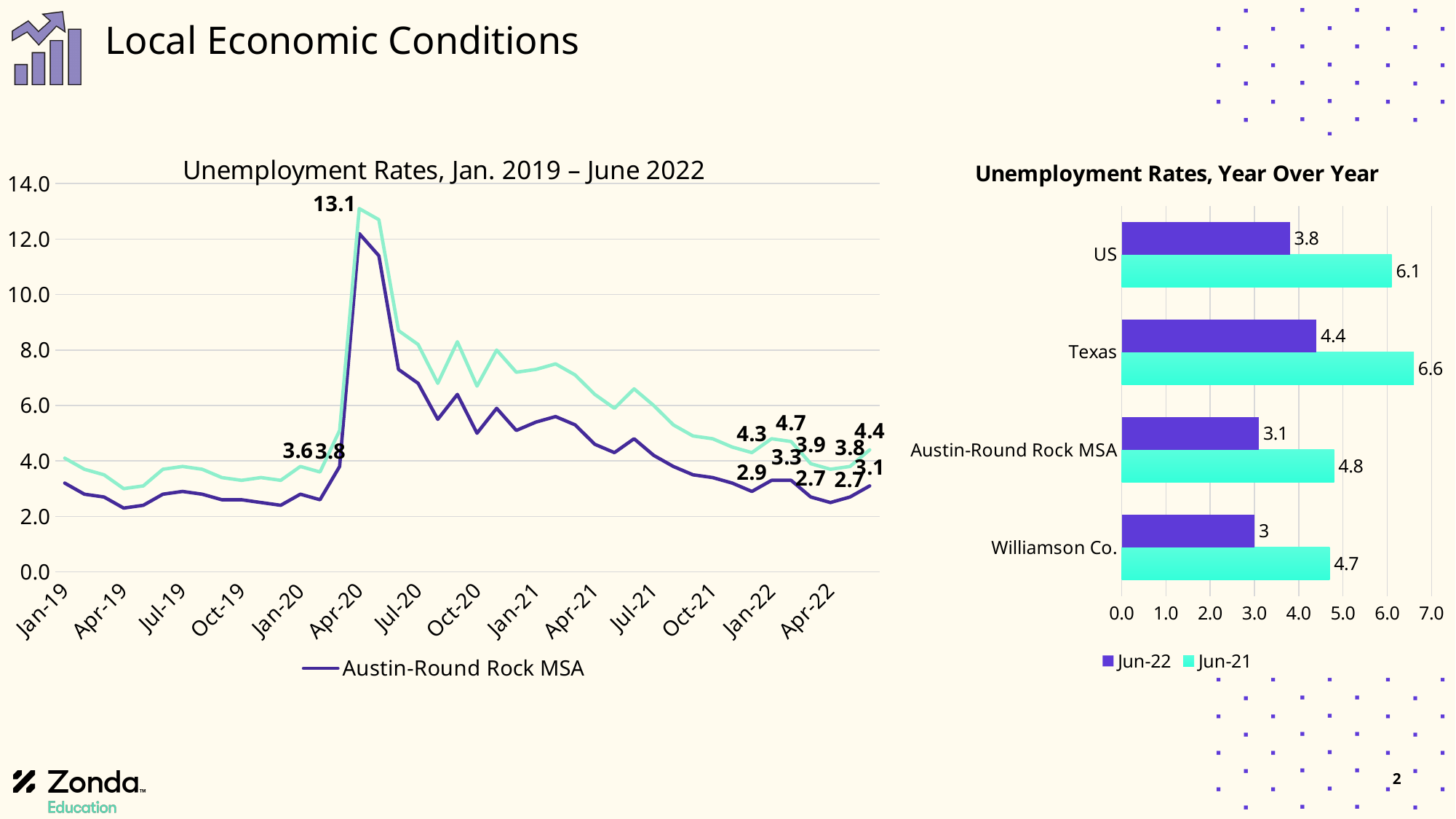
On the 'Unemployment Rates, Year Over Year' chart, how many categories are shown? 4 On the 'Unemployment Rates, Year Over Year' chart, how many series does the legend list? 2 On the 'Unemployment Rates, Year Over Year' chart, which category has the lowest Jun-22 value? Williamson Co. On the 'Unemployment Rates, Year Over Year' chart, what is the Jun-22 value for Williamson Co.? 3 What kind of chart is 'Unemployment Rates, Year Over Year'? Bar chart On the 'Unemployment Rates, Jan. 2019 – June 2022' chart, what is the highest value labeled on the chart? 13.1 On the 'Unemployment Rates, Year Over Year' chart, what is the Jun-22 value for Texas? 4.4 On the 'Unemployment Rates, Year Over Year' chart, which is larger: the Jun-22 value for the US or the Jun-22 value for Texas? Texas On the 'Unemployment Rates, Year Over Year' chart, which category has the highest Jun-21 value? Texas On the 'Unemployment Rates, Year Over Year' chart, what is the difference between the Jun-21 and Jun-22 values for Austin-Round Rock MSA? 1.7 What kind of chart is 'Unemployment Rates, Jan. 2019 – June 2022'? Line chart On the 'Unemployment Rates, Year Over Year' chart, what is the Jun-21 value for the US? 6.1